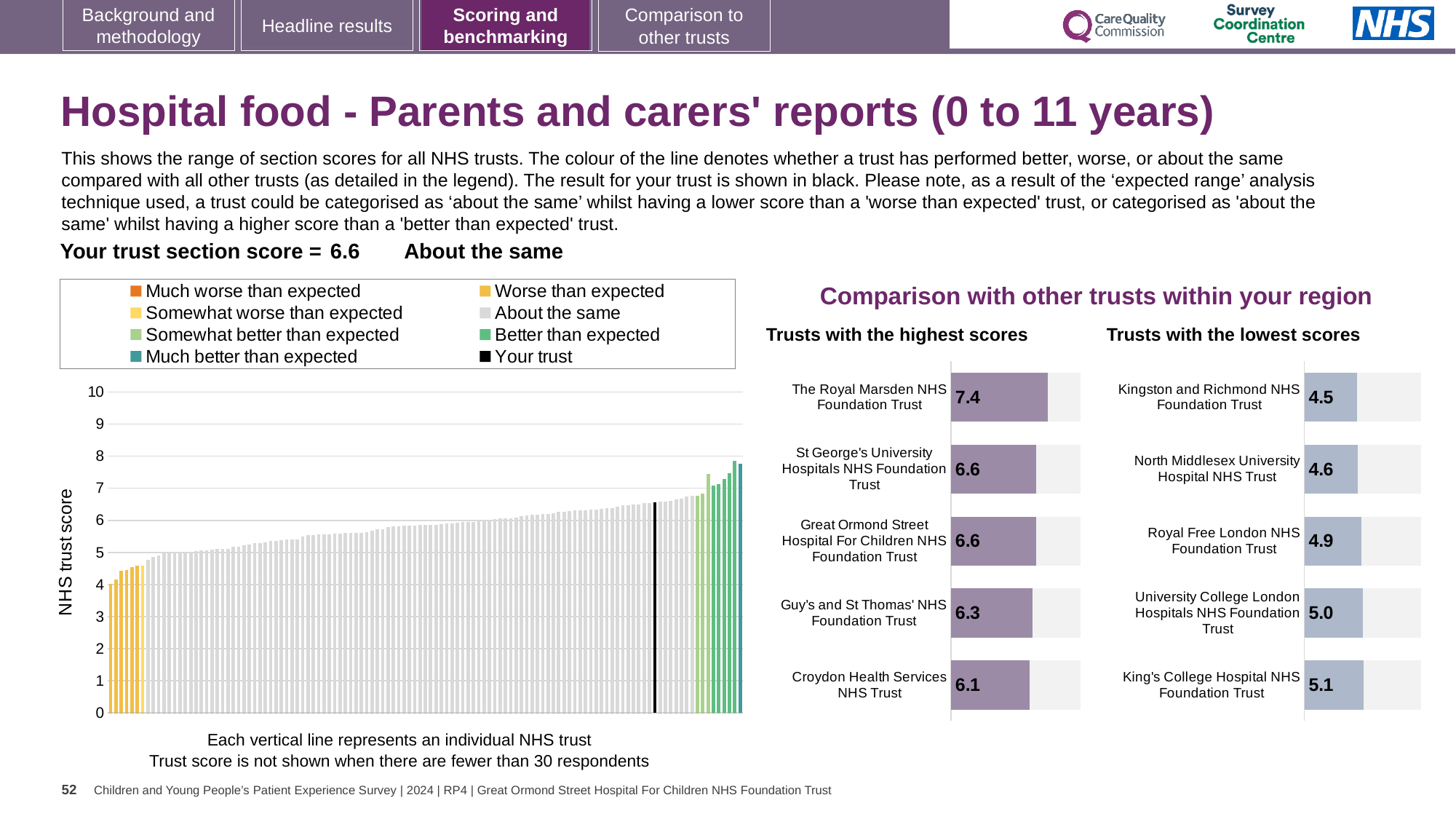
What kind of chart is the main 'NHS trust score' chart on the left? Bar chart In the main 'NHS trust score' chart, do the values rise or fall from left to right along the x axis? Rise In the 'Trusts with the lowest scores' chart, which is larger: the score for King's College Hospital NHS Foundation Trust or North Middlesex University Hospital NHS Trust? King's College Hospital NHS Foundation Trust In the 'Trusts with the highest scores' chart, what is the difference between The Royal Marsden NHS Foundation Trust and Guy's and St Thomas' NHS Foundation Trust? 1.1 In the 'Trusts with the lowest scores' chart, which trust has the lowest score? Kingston and Richmond NHS Foundation Trust In the main 'NHS trust score' chart, is the value of the tallest bar greater or less than 7? greater In the 'Trusts with the highest scores' chart, what is the score for The Royal Marsden NHS Foundation Trust? 7.4 How many trusts are shown in the 'Trusts with the lowest scores' chart? 5 In the 'Trusts with the highest scores' chart, what is the score for Croydon Health Services NHS Trust? 6.1 In the main 'NHS trust score' chart on the left, what is the section score for your trust (the black bar)? 6.6 In the 'Trusts with the lowest scores' chart, what is the score for Royal Free London NHS Foundation Trust? 4.9 How many entries does the legend of the main 'NHS trust score' chart list? 8